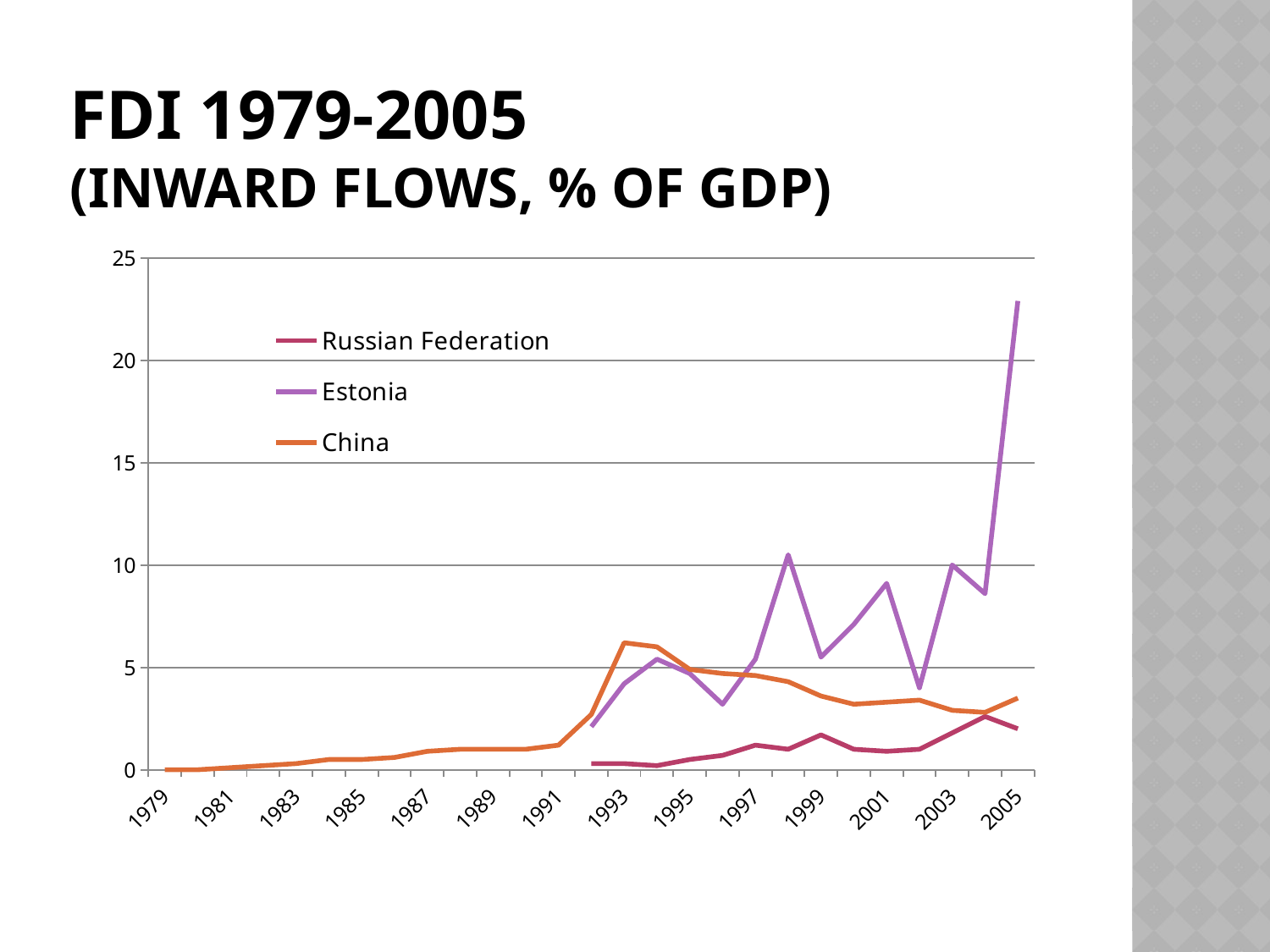
Which series reaches the highest value anywhere on the chart? Estonia Is the value for the Russian Federation in 1993 greater or less than 5? less How many series does the legend list? 3 Does the line for Estonia rise or fall between 2004 and 2005? rise Does the line for China rise or fall between 1979 and 1993? rise Which series has data starting in 1979, earlier than the other two? China What kind of chart is shown on the slide? line chart In 1993, which is larger: the value for China or the value for the Russian Federation? China Is the value for Estonia in 2005 greater or less than 20? greater Is the value for China in 1993 greater or less than 5? greater In 1998, which is larger: the value for Estonia or the value for China? Estonia